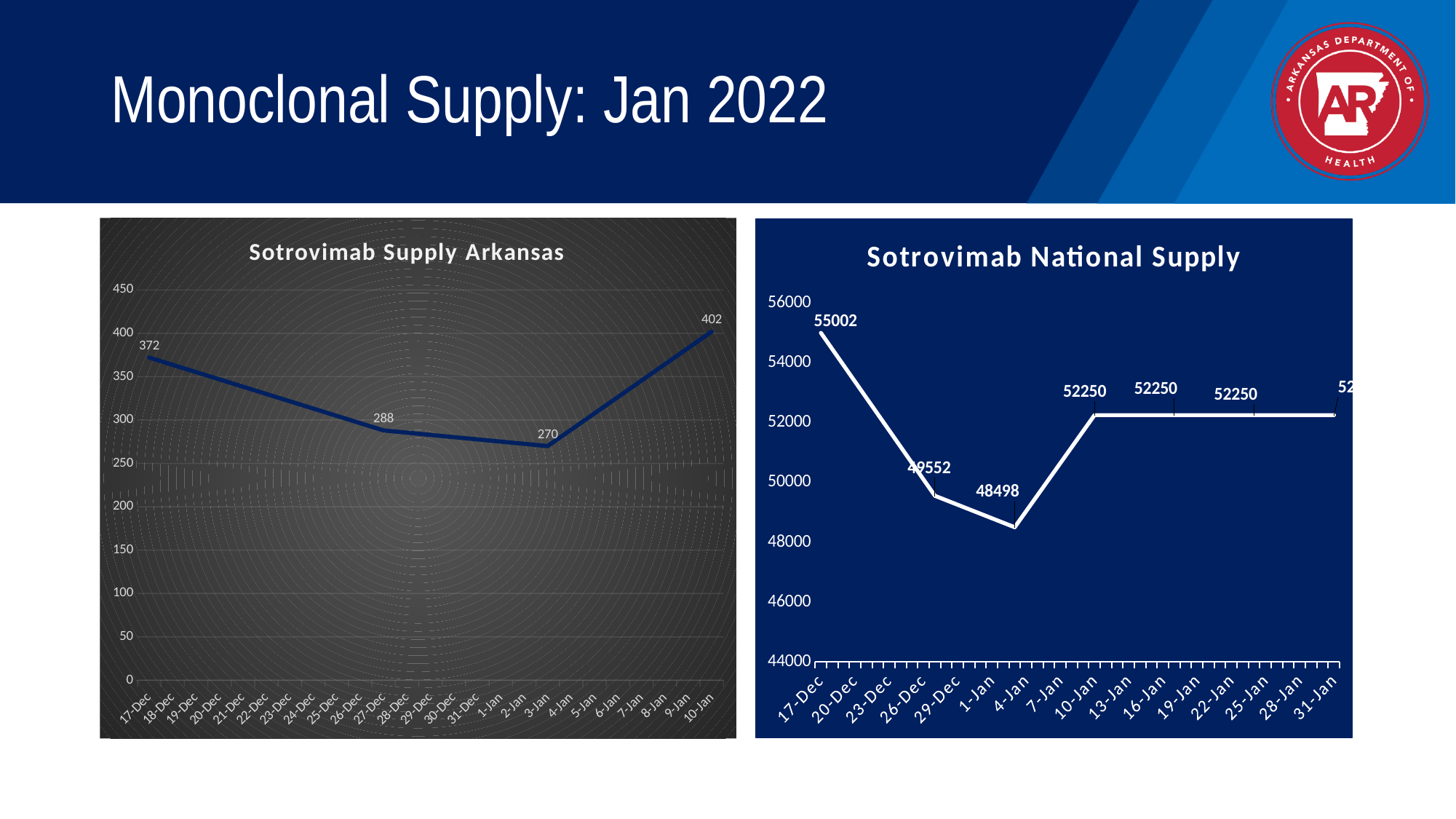
In the "Sotrovimab Supply Arkansas" chart, what is the value on 17-Dec? 372 In the "Sotrovimab Supply Arkansas" chart, what is the value on 3-Jan? 270 In the "Sotrovimab National Supply" chart, what is the difference between the highest labeled value (55002) and the lowest labeled value (48498)? 6504 In the "Sotrovimab Supply Arkansas" chart, what is the value on 10-Jan? 402 In the "Sotrovimab National Supply" chart, does the line rise or fall between 17-Dec and 26-Dec? Fall In the "Sotrovimab National Supply" chart, what is the value on 17-Dec? 55002 In the "Sotrovimab Supply Arkansas" chart, how many data points are labeled with values? 4 What kind of chart is the "Sotrovimab Supply Arkansas" chart? Line chart In the "Sotrovimab Supply Arkansas" chart, which date has the lowest labeled value? 3-Jan In the "Sotrovimab National Supply" chart, what is the lowest labeled value? 48498 In the "Sotrovimab Supply Arkansas" chart, what is the difference between the values on 10-Jan and 17-Dec? 30 In the "Sotrovimab Supply Arkansas" chart, which date has the highest labeled value? 10-Jan